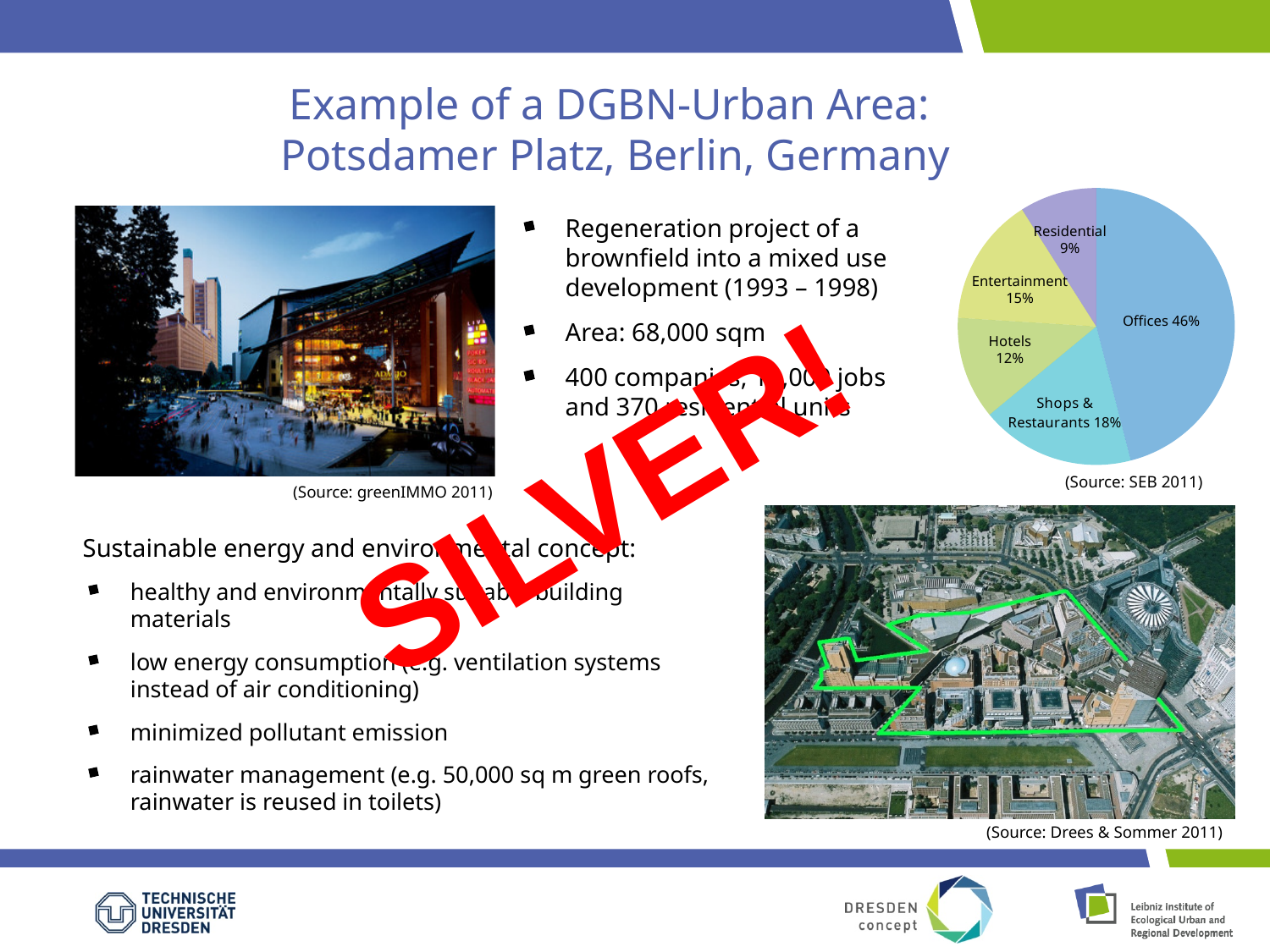
How many categories does the pie chart show? 5 What share of the pie chart is Shops & Restaurants? 18% Which category has the smallest slice in the pie chart? Residential What source is cited below the pie chart? SEB 2011 Which category has the largest slice in the pie chart? Offices What share of the pie chart is Offices? 46% Which is larger in the pie chart, Entertainment or Hotels? Entertainment What share of the pie chart is Residential? 9% What is the difference in percentage points between Offices and Shops & Restaurants in the pie chart? 28 What share of the pie chart is Hotels? 12% What kind of chart is shown on the slide? pie chart What share of the pie chart is Entertainment? 15%